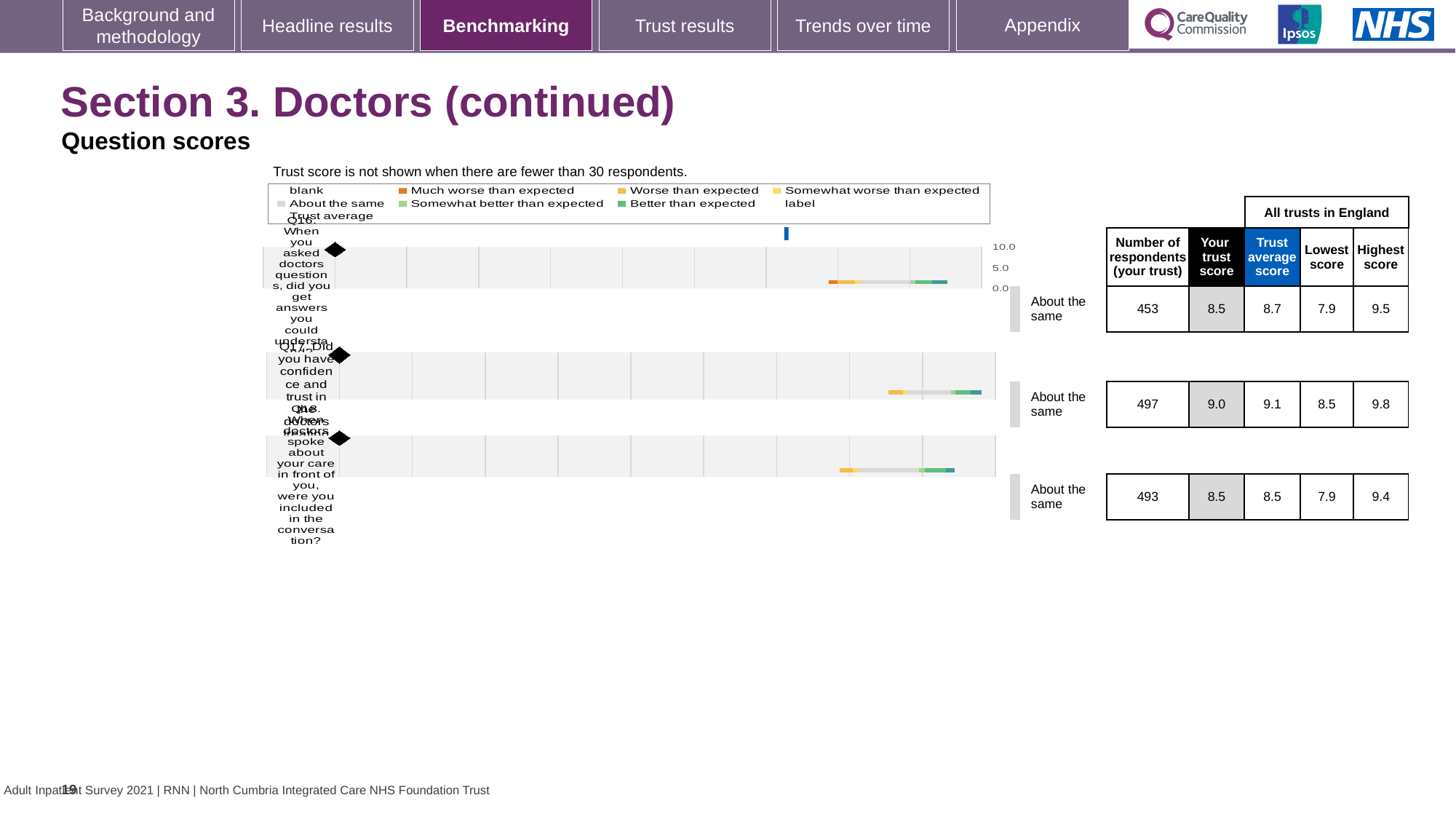
What benchmark category is shown for all three questions? About the same How many respondents from your trust answered Q16 (When you asked doctors questions, did you get answers you could understand)? 453 What is the difference between the highest score and the lowest score for Q18? 1.5 Which question has the largest number of respondents from your trust? Q17 What kind of chart is used to show the question scores? Bar chart What is your trust score for Q17 (Did you have confidence and trust in the doctors treating you)? 9.0 What is the trust average score for Q18 (When doctors spoke about your care in front of you, were you included in the conversation)? 8.5 How many questions are plotted on the chart? 3 What is the lowest score across all trusts in England for Q16? 7.9 Which question has the highest 'Your trust score'? Q17 What is the highest score across all trusts in England for Q17? 9.8 Which is larger: the trust average score for Q16 or the trust average score for Q18? Q16